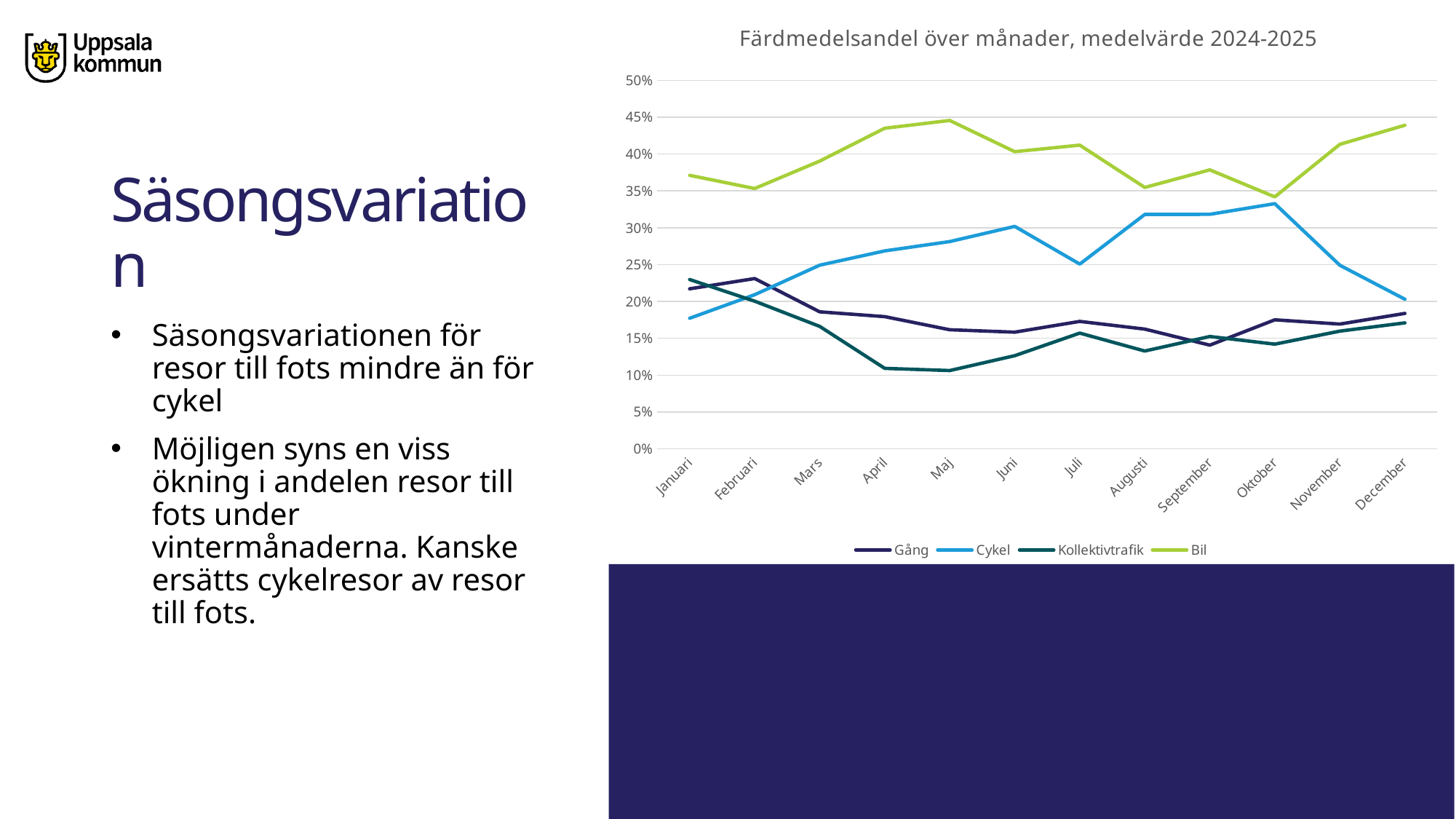
Is the value for Kollektivtrafik in April greater or less than 15%? less Is the value for Bil in Maj greater or less than 40%? greater What kind of chart is shown on the slide? line chart Which series has the lowest value in Maj? Kollektivtrafik What is the title of the chart? Färdmedelsandel över månader, medelvärde 2024-2025 How many series does the chart legend list? 4 Which series has the highest value in Januari? Bil Is the value for Gång in Oktober greater or less than 15%? greater In Juli, which series has the larger value, Cykel or Gång? Cykel Does the Cykel line rise or fall from Januari to Juni? rise How many months are plotted along the x axis? 12